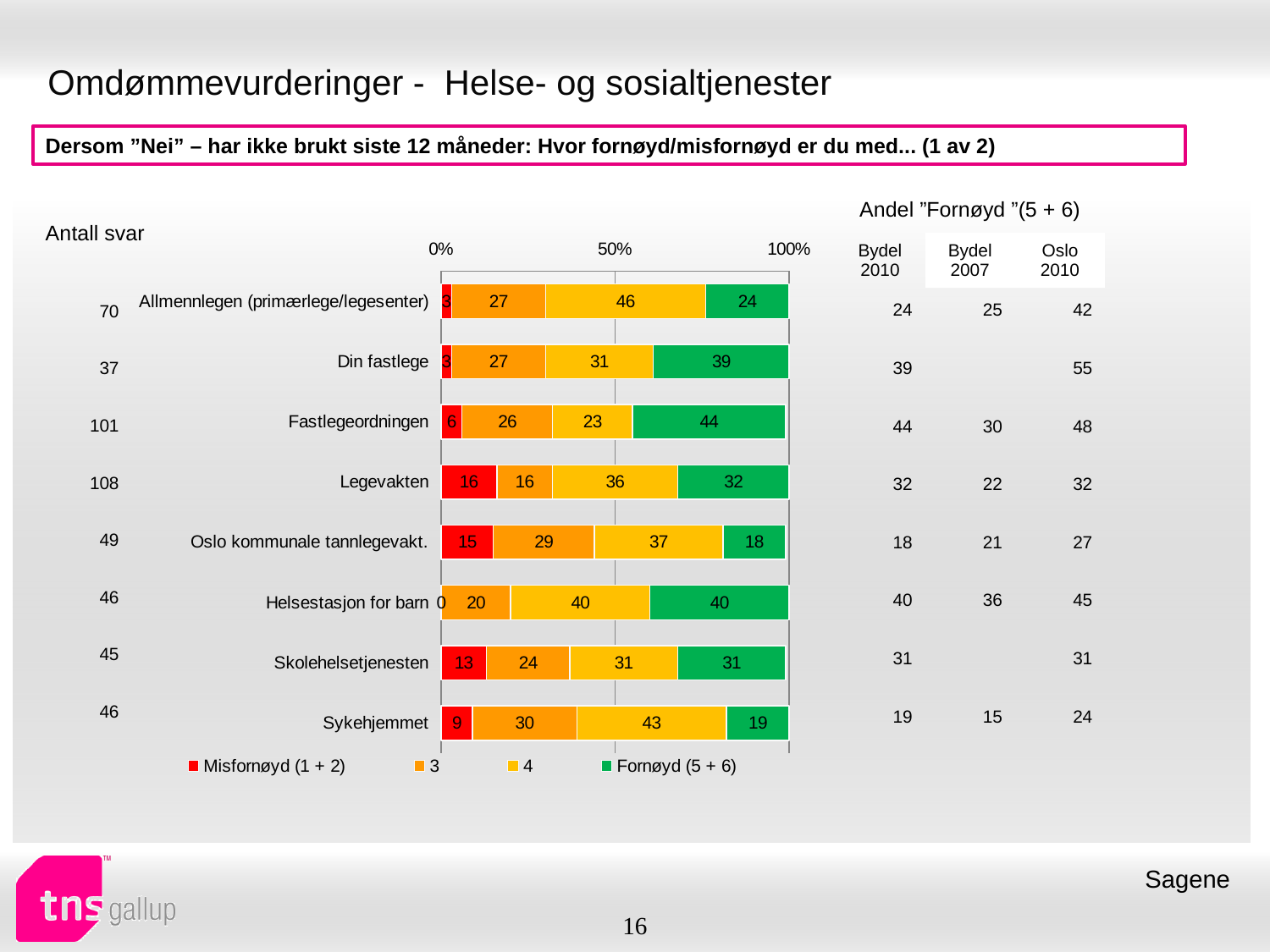
What is the difference between the "Fornøyd (5 + 6)" values for Din fastlege and Allmennlegen (primærlege/legesenter)? 15 How many series does the legend list? 4 How many categories are shown in the bar chart? 8 What is the value of the "Fornøyd (5 + 6)" segment for Fastlegeordningen? 44 What is the value of the "Misfornøyd (1 + 2)" segment for Legevakten? 16 Which has a larger "Misfornøyd (1 + 2)" value, Skolehelsetjenesten or Sykehjemmet? Skolehelsetjenesten What is the value of the "4" segment for Sykehjemmet? 43 Which category has the lowest "Fornøyd (5 + 6)" value? Oslo kommunale tannlegevakt. What kind of chart is shown on the slide? Stacked bar chart What is the value of the "3" segment for Oslo kommunale tannlegevakt.? 29 What colour represents the "Fornøyd (5 + 6)" series in the chart? Green Which category has the highest "Fornøyd (5 + 6)" value? Fastlegeordningen